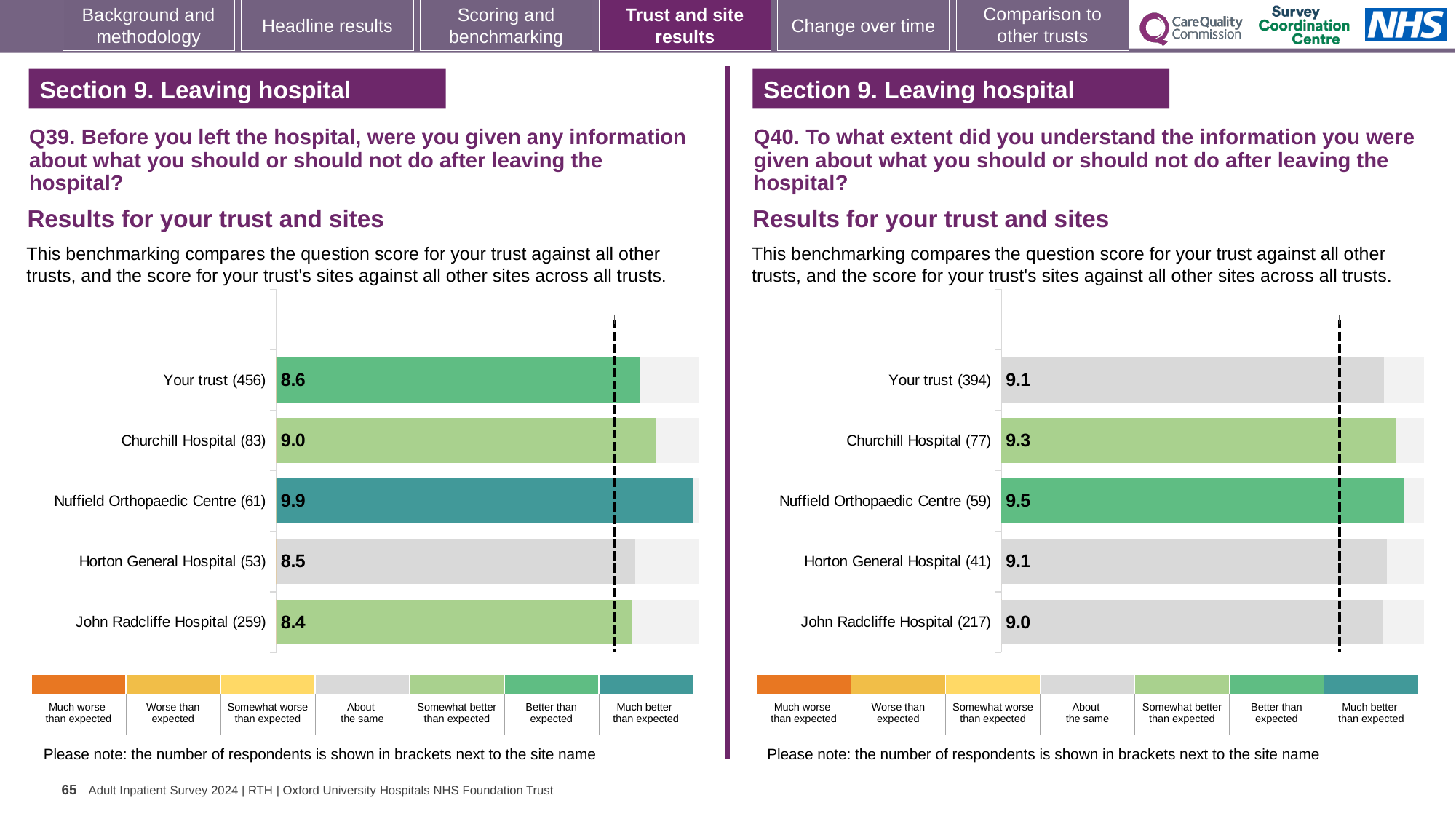
On the Q40 chart (right), what is the score for Churchill Hospital? 9.3 On the Q39 chart (left), what is the score for Your trust? 8.6 On the Q39 chart (left), which site has the lowest score? John Radcliffe Hospital On the Q40 chart (right), what is the score for John Radcliffe Hospital? 9.0 On the Q40 chart (right), what is the difference between the scores for Nuffield Orthopaedic Centre and Your trust? 0.4 On the Q39 chart (left), what is the score for Nuffield Orthopaedic Centre? 9.9 What type of chart is used on the Q40 chart (right)? Bar chart On the Q40 chart (right), which is larger: the score for Churchill Hospital or the score for Horton General Hospital? Churchill Hospital On the Q39 chart (left), what is the difference between the scores for Churchill Hospital and Horton General Hospital? 0.5 How many bars are shown on the Q39 chart (left)? 5 On the Q40 chart (right), which site has the highest score? Nuffield Orthopaedic Centre On the Q39 chart (left), which site has the highest score? Nuffield Orthopaedic Centre